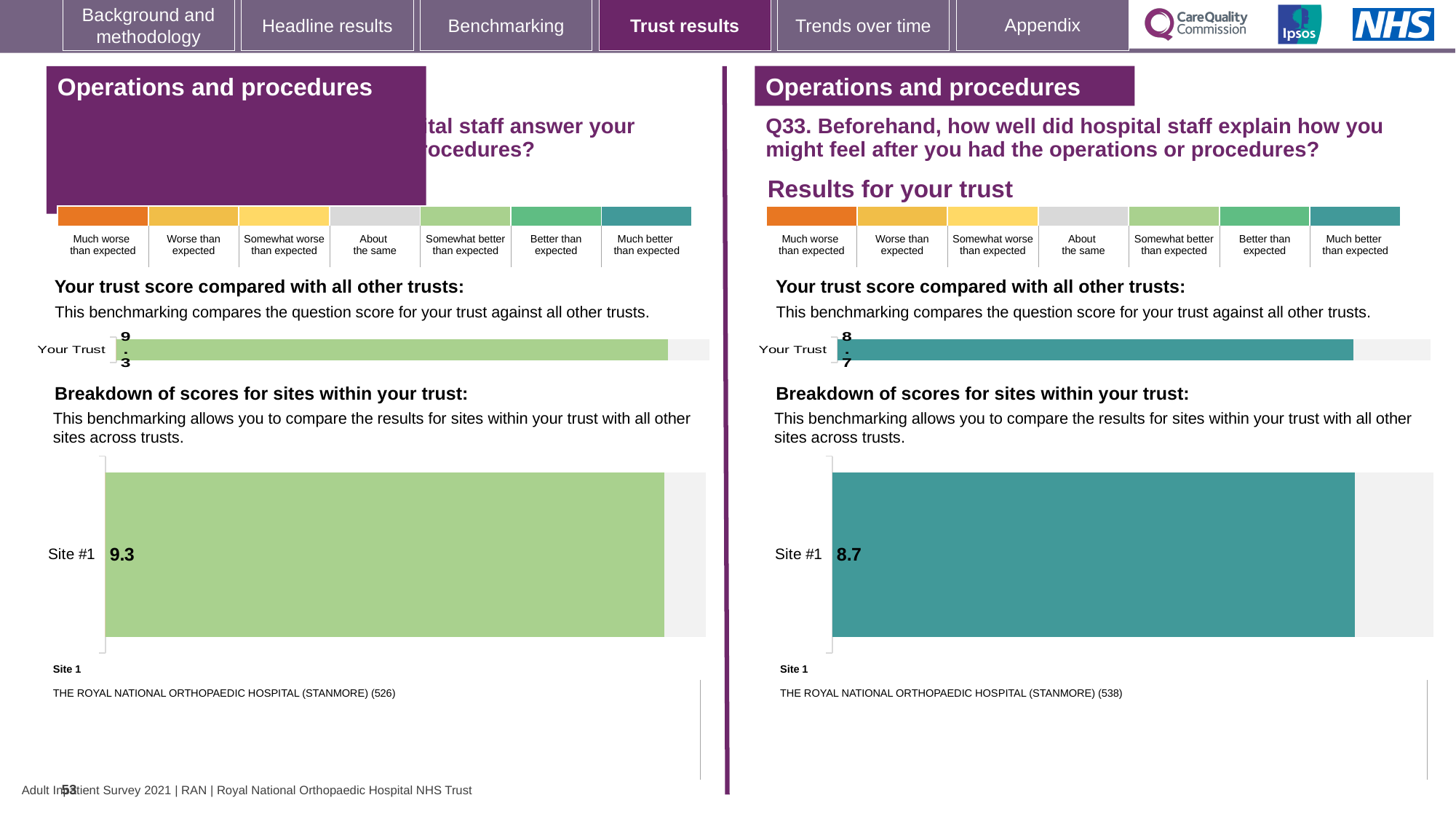
What colour is the Site #1 bar in the right chart (Q33)? teal Which has the higher Site #1 score: the left chart or the right chart (Q33)? the left chart What is the difference between the Site #1 score on the left chart (9.3) and the Site #1 score on the right chart (8.7)? 0.6 On the left half of the slide, what is the score shown for Your Trust? 9.3 How many sites are shown in the left 'Breakdown of scores for sites within your trust' chart? 1 On the right half of the slide (Q33), what is the score shown for Your Trust? 8.7 What type of chart is used to show the Site #1 score on the right half of the slide (Q33)? bar chart Which site is listed as Site 1 below the right chart (Q33)? THE ROYAL NATIONAL ORTHOPAEDIC HOSPITAL (STANMORE) (538) In the left 'Breakdown of scores for sites within your trust' chart, what is the score for Site #1? 9.3 How many sites are shown in the right 'Breakdown of scores for sites within your trust' chart (Q33)? 1 In the right 'Breakdown of scores for sites within your trust' chart (Q33), what is the score for Site #1? 8.7